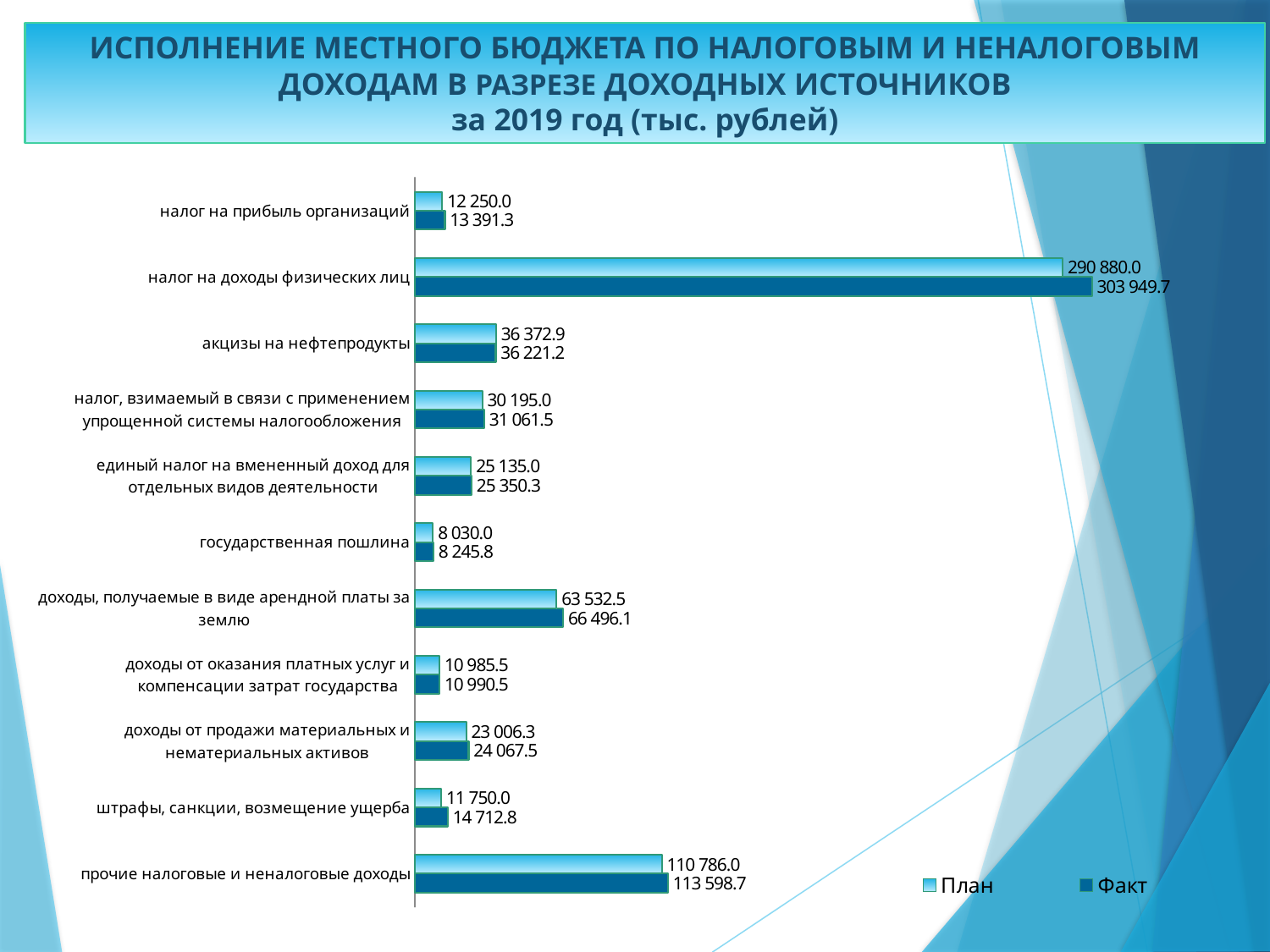
What is the Факт value for доходы, получаемые в виде арендной платы за землю? 66 496.1 What is the План value for налог на доходы физических лиц? 290 880.0 What is the План value for прочие налоговые и неналоговые доходы? 110 786.0 What is the Факт value for штрафы, санкции, возмещение ущерба? 14 712.8 How many categories are shown in the chart? 11 How many series does the legend list? 2 Which category has the lowest План value? государственная пошлина Which category has the highest Факт value? налог на доходы физических лиц What is the difference between the Факт and План values for штрафы, санкции, возмещение ущерба? 2 962.8 For акцизы на нефтепродукты, which is larger: the План value or the Факт value? План What type of chart is shown on the slide? bar chart What is the difference between the Факт and План values for налог на прибыль организаций? 1 141.3